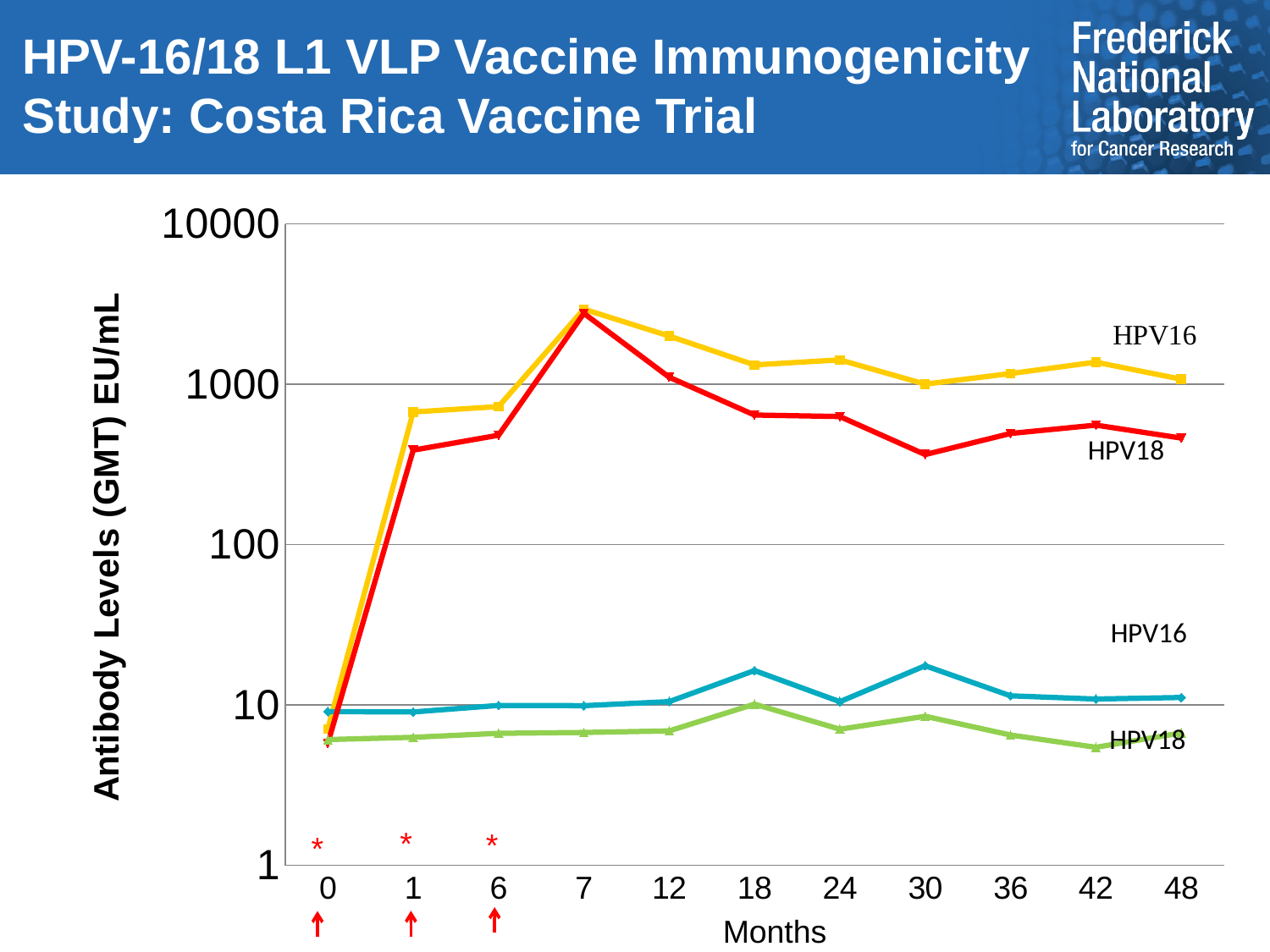
How many lines are plotted on the chart? 4 How many time points are marked on the Months axis? 11 Is the value of the lower HPV18 line at month 42 greater or less than 10? less What kind of chart is shown on the slide? line chart At month 30, which is higher: the upper HPV16 line or the upper HPV18 line? HPV16 Is the value of the upper HPV18 line at month 1 greater or less than 100? greater What is the label of the x axis? Months Is the value of the upper HPV18 line at month 30 greater or less than 1000? less What is the label of the y axis? Antibody Levels (GMT) EU/mL At which month does the upper HPV16 line reach its highest value? 7 Does the upper HPV18 line rise or fall between month 7 and month 12? fall